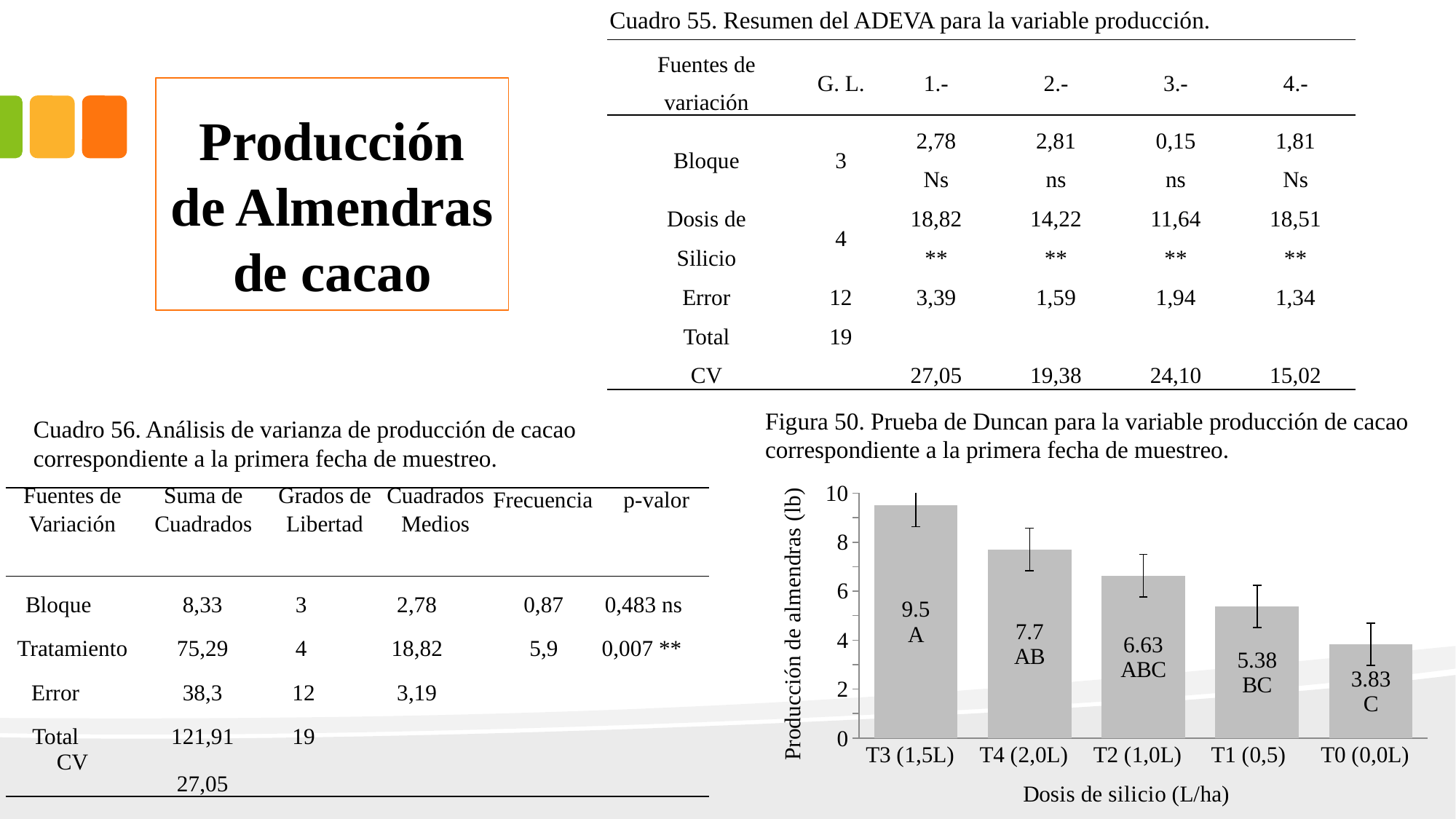
In Figura 50, which dose has the highest production? T3 (1,5L) In Figura 50, what is the value for T3 (1,5L)? 9.5 In Figura 50, which dose has the lowest production? T0 (0,0L) What type of chart is Figura 50? bar chart In Figura 50, which is larger, the value for T4 (2,0L) or T2 (1,0L)? T4 (2,0L) In Figura 50, what is the value for T0 (0,0L)? 3.83 In Figura 50, what is the value for T2 (1,0L)? 6.63 In Figura 50, what is the difference between the values for T3 (1,5L) and T0 (0,0L)? 5.67 In Figura 50, what is the label of the y axis? Producción de almendras (lb) In Figura 50, how many bars are plotted? 5 In Figura 50, what is the difference between the values for T4 (2,0L) and T1 (0,5)? 2.32 In Figura 50, do the values rise or fall from left to right along the x axis? fall